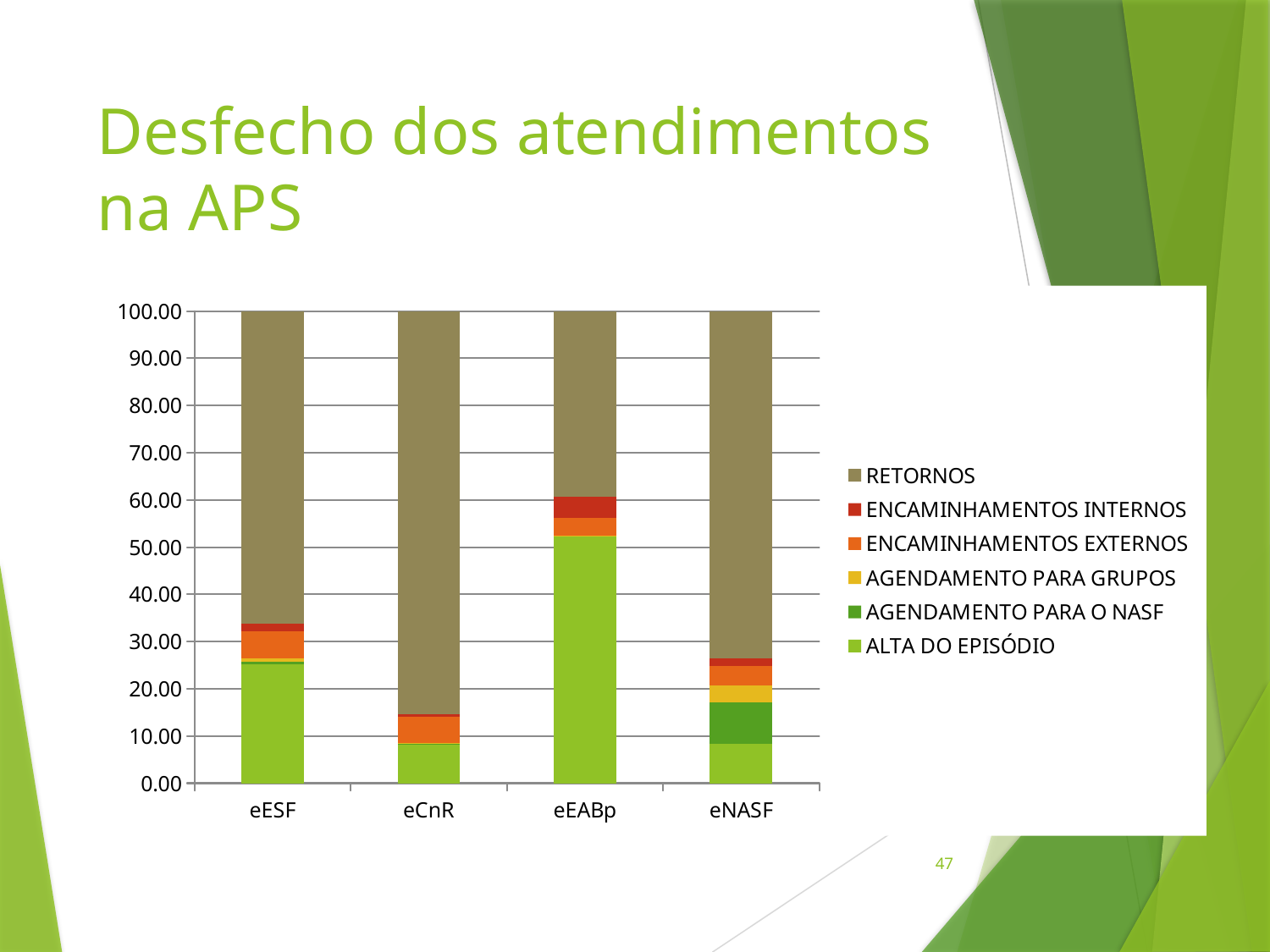
Is the ALTA DO EPISÓDIO value for eCnR greater or less than 10.00? less Which category has the smallest RETORNOS segment? eEABp Is the ALTA DO EPISÓDIO value for eEABp greater or less than 40.00? greater Which category has the largest ALTA DO EPISÓDIO segment? eEABp Which is larger, the ALTA DO EPISÓDIO segment for eESF or for eEABp? eEABp How many categories are shown on the x axis of the chart? 4 How many series does the chart legend list? 6 What kind of chart is shown on the slide? stacked bar chart What is the title of the slide containing the chart? Desfecho dos atendimentos na APS Which category has the largest RETORNOS segment? eCnR What is the total height of each stacked bar on the y axis? 100.00 Is the ALTA DO EPISÓDIO value for eESF greater or less than 30.00? less